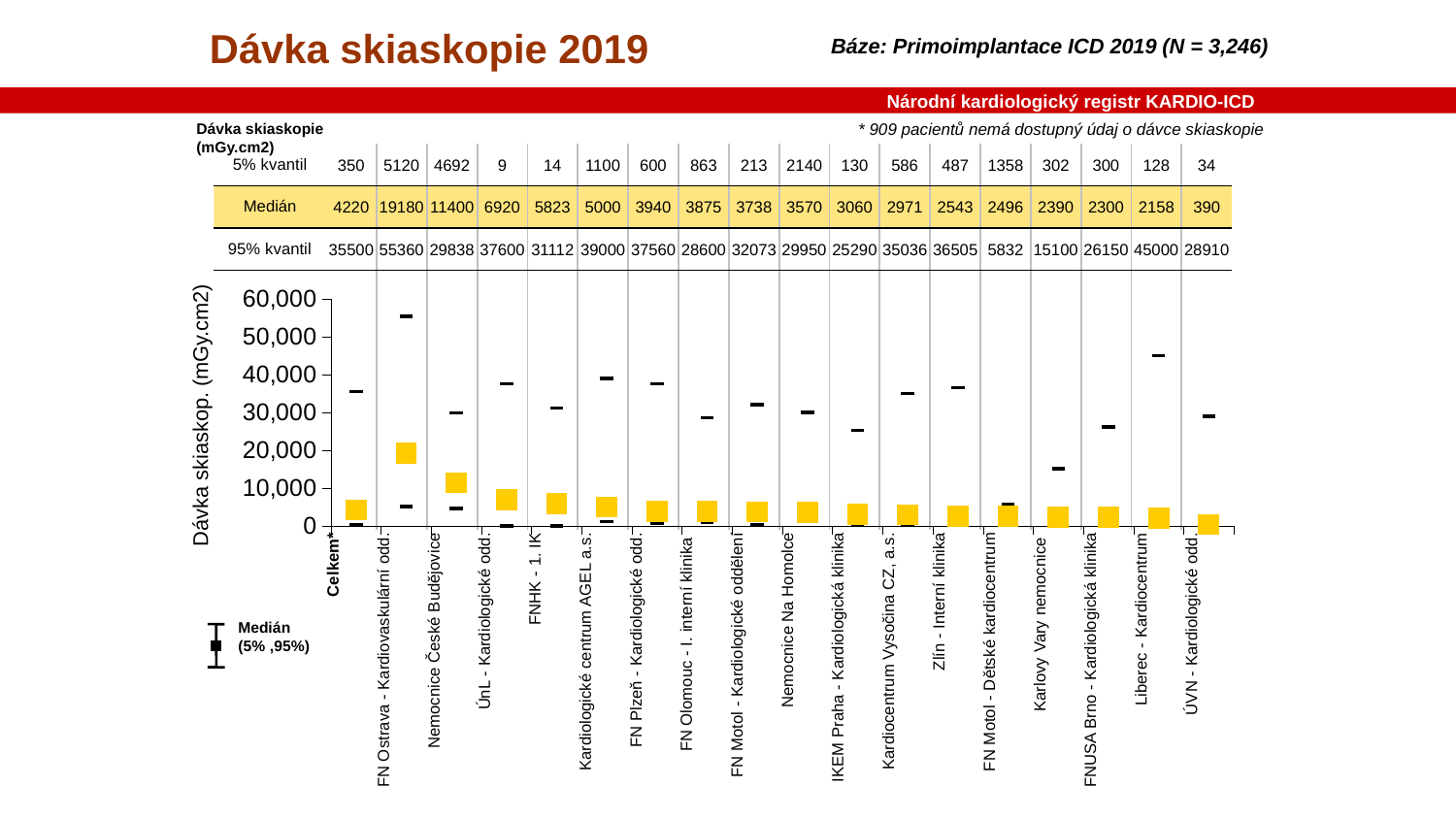
Is the 95% kvantil marker for FN Ostrava - Kardiovaskulární odd. greater or less than 50,000 on the chart? greater How many categories are shown on the x axis of the chart? 18 What is the difference between the median values of FN Ostrava - Kardiovaskulární odd. and Nemocnice České Budějovice? 7780 Which has the larger median value: Zlín - Interní klinika or Karlovy Vary nemocnice? Zlín - Interní klinika Which category has the lowest median (Medián) value? ÚVN - Kardiologické odd. Do the median values rise or fall along the x axis from FN Ostrava - Kardiovaskulární odd. to ÚVN - Kardiologické odd.? fall Which category has the lowest 95% kvantil value? FN Motol - Dětské kardiocentrum What is the 95% kvantil value for Liberec - Kardiocentrum? 45000 What is the 5% kvantil value for Nemocnice Na Homolce? 2140 What is the label of the y axis of the chart? Dávka skiaskop. (mGy.cm2) What is the median (Medián) value for FN Ostrava - Kardiovaskulární odd.? 19180 Which category has the highest median (Medián) value? FN Ostrava - Kardiovaskulární odd.